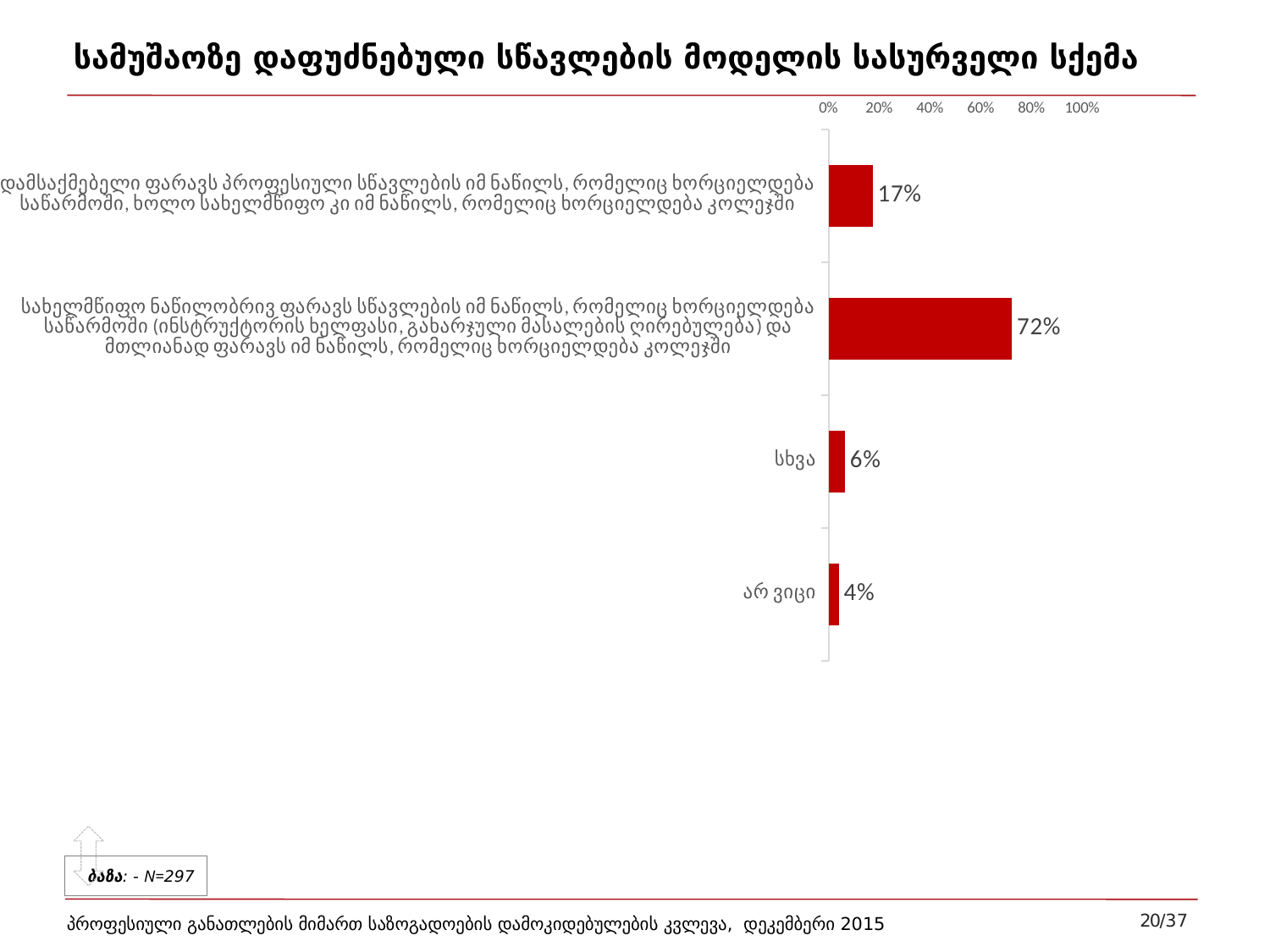
What is the title of the chart on the slide? სამუშაოზე დაფუძნებული სწავლების მოდელის სასურველი სქემა Which is larger: the value for "სხვა" or the value for "არ ვიცი"? სხვა Which category has the lowest value? არ ვიცი What is the value for the option beginning "დამსაქმებელი ფარავს პროფესიული სწავლების იმ ნაწილს..."? 17% What type of chart is shown on the slide? bar chart What is the value for the option beginning "სახელმწიფო ნაწილობრივ ფარავს სწავლების იმ ნაწილს..."? 72% What sample size (N) is stated in the base note on the slide? N=297 How many categories (bars) does the chart show? 4 What is the value for the category "სხვა"? 6% What is the value for the category "არ ვიცი"? 4% Which category has the highest value? სახელმწიფო ნაწილობრივ ფარავს სწავლების იმ ნაწილს, რომელიც ხორციელდება საწარმოში (ინსტრუქტორის ხელფასი, გახარჯული მასალების ღირებულება) და მთლიანად ფარავს იმ ნაწილს, რომელიც ხორციელდება კოლეჯში What is the difference between the highest value (72%) and the value for the option beginning "დამსაქმებელი ფარავს..." (17%)? 55%